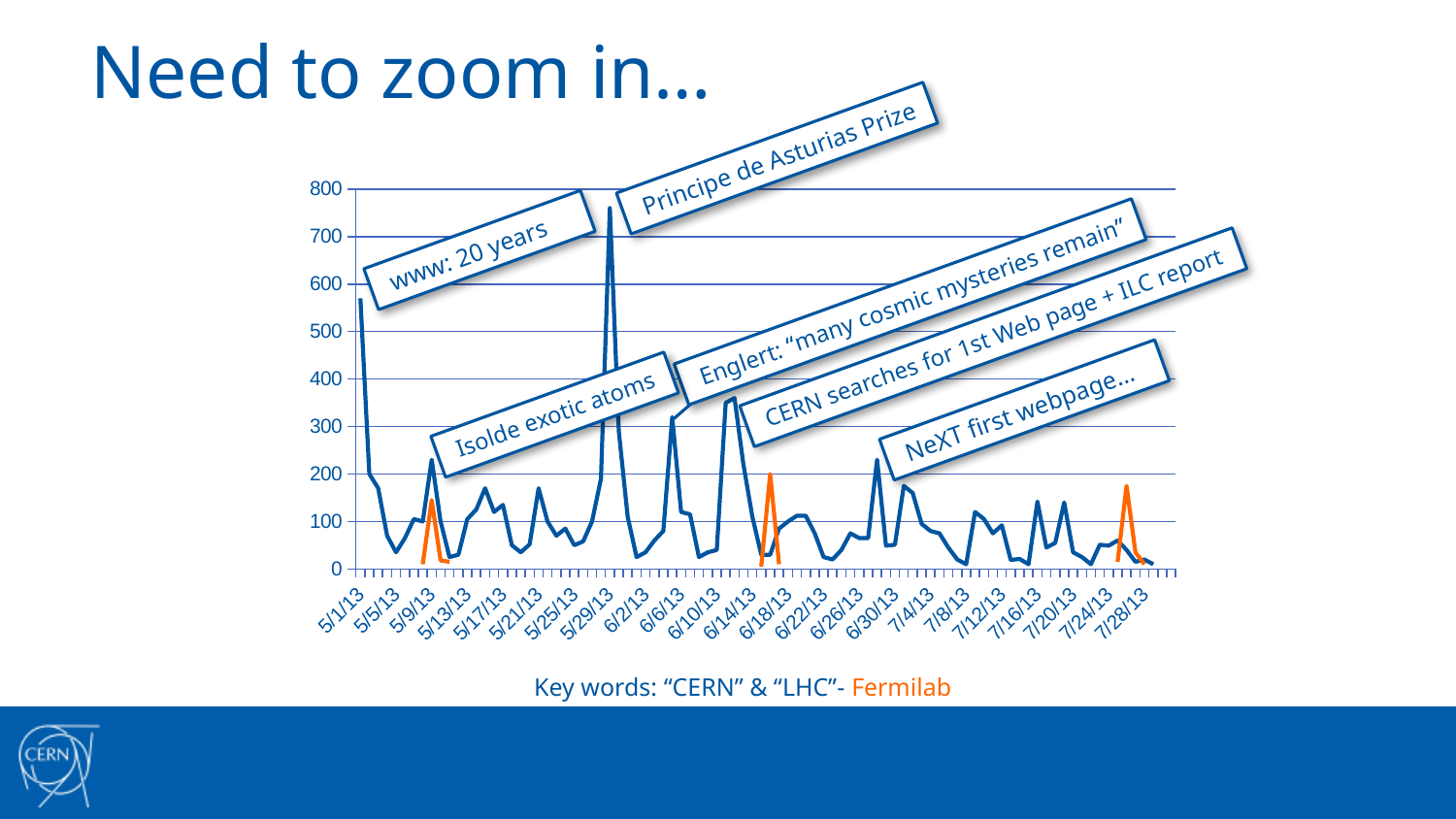
Is the peak of the orange line near 6/18/13 greater or less than 300? less Which key words does the orange line represent, according to the caption below the chart? Fermilab Do the peaks of the blue line generally rise or fall from May to late July? fall How many data series (lines) are plotted on the chart? 2 Which annotated event is attached to the highest peak of the blue line? Principe de Asturias Prize What kind of chart is shown on the slide? line chart Which line reaches higher values overall, the blue line or the orange line? the blue line Is the peak of the orange line near 5/9/13 greater or less than 200? less Is the value of the blue line at 5/1/13 greater or less than 500? greater What is the highest value shown on the y axis of the chart? 800